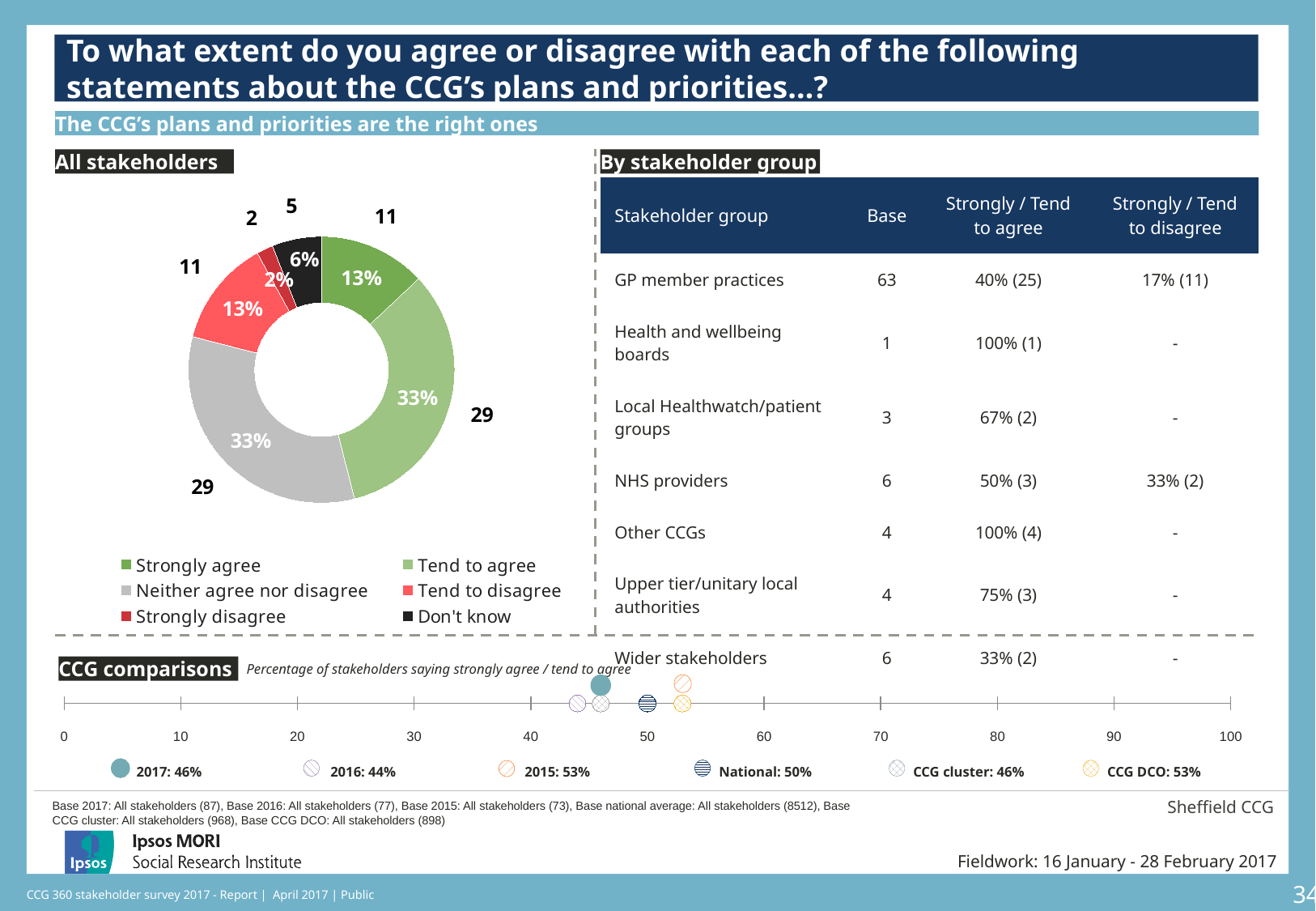
In the All stakeholders chart, what is the combined percentage of Strongly agree and Tend to agree? 46% In the All stakeholders chart, which response has the smallest share? Strongly disagree In the CCG comparisons chart, what percentage of stakeholders said strongly agree / tend to agree in 2017? 46% In the All stakeholders chart, what colour represents Neither agree nor disagree? Grey In the All stakeholders chart, what is the difference in percentage points between Strongly agree and Strongly disagree? 11 How many response categories does the legend of the All stakeholders chart list? 6 In the All stakeholders chart, what percentage of stakeholders tend to agree? 33% In the All stakeholders chart, which is larger: the share for Don't know or the share for Strongly disagree? Don't know In the CCG comparisons chart, what is the difference in percentage points between the 2015 and 2016 values? 9 In the All stakeholders chart, how many stakeholders strongly agree? 11 In the All stakeholders chart, what percentage of stakeholders answered Don't know? 6% What type of chart is the All stakeholders chart? Pie (donut) chart